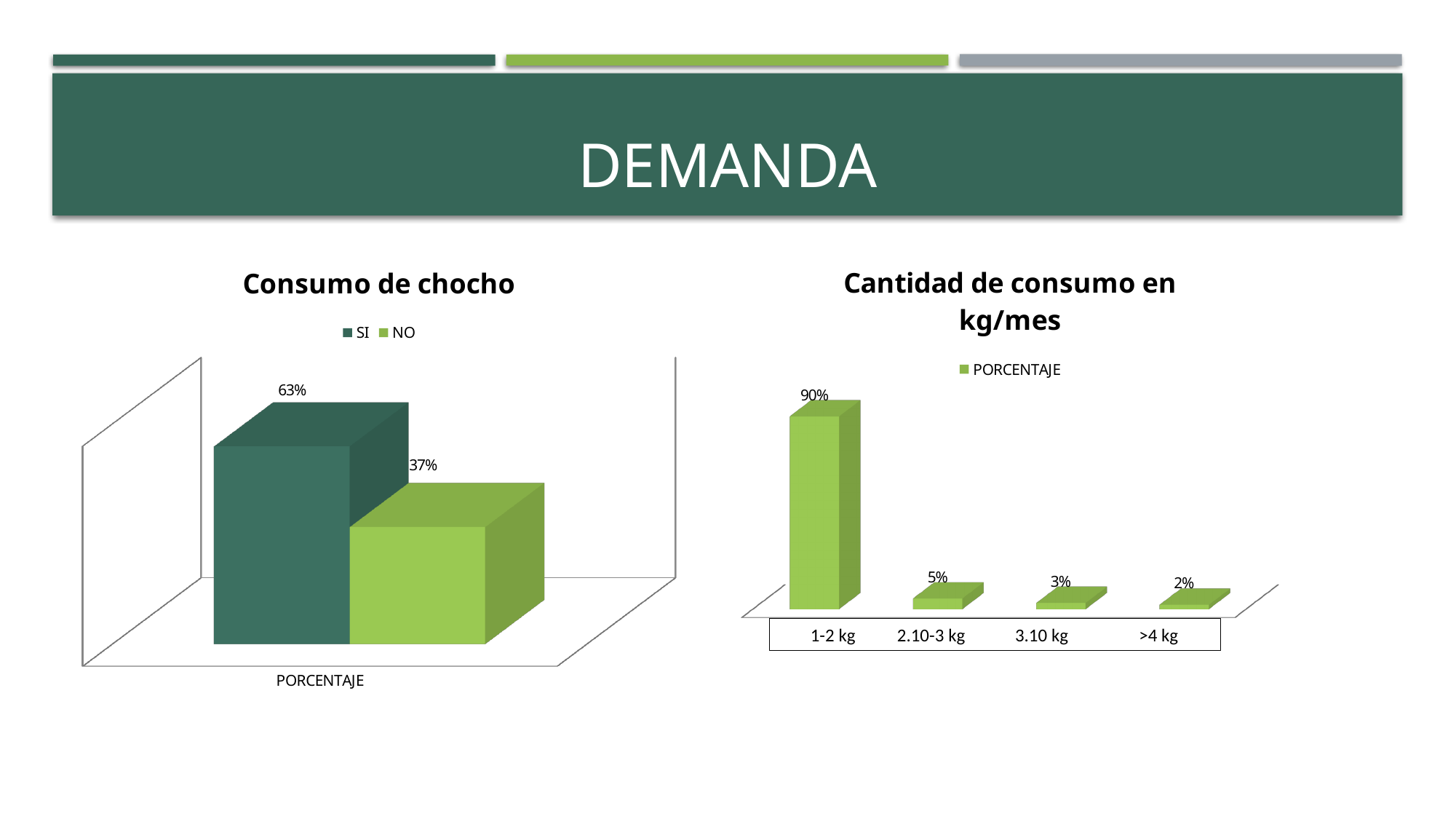
In the 'Cantidad de consumo en kg/mes' chart, which category has the lowest value? >4 kg In the 'Cantidad de consumo en kg/mes' chart, which category has the highest value? 1-2 kg What kind of chart is the 'Cantidad de consumo en kg/mes' chart? Bar chart In the 'Consumo de chocho' chart, what is the value for NO? 37% In the 'Cantidad de consumo en kg/mes' chart, what is the value for 1-2 kg? 90% In the 'Consumo de chocho' chart, what is the value for SI? 63% In the 'Cantidad de consumo en kg/mes' chart, how many categories are shown? 4 In the 'Cantidad de consumo en kg/mes' chart, what is the value for 2.10-3 kg? 5% In the 'Consumo de chocho' chart, what is the difference between SI and NO? 26% In the 'Consumo de chocho' chart, which is larger, SI or NO? SI In the 'Cantidad de consumo en kg/mes' chart, what is the value for >4 kg? 2% In the 'Consumo de chocho' chart, how many series does the legend list? 2